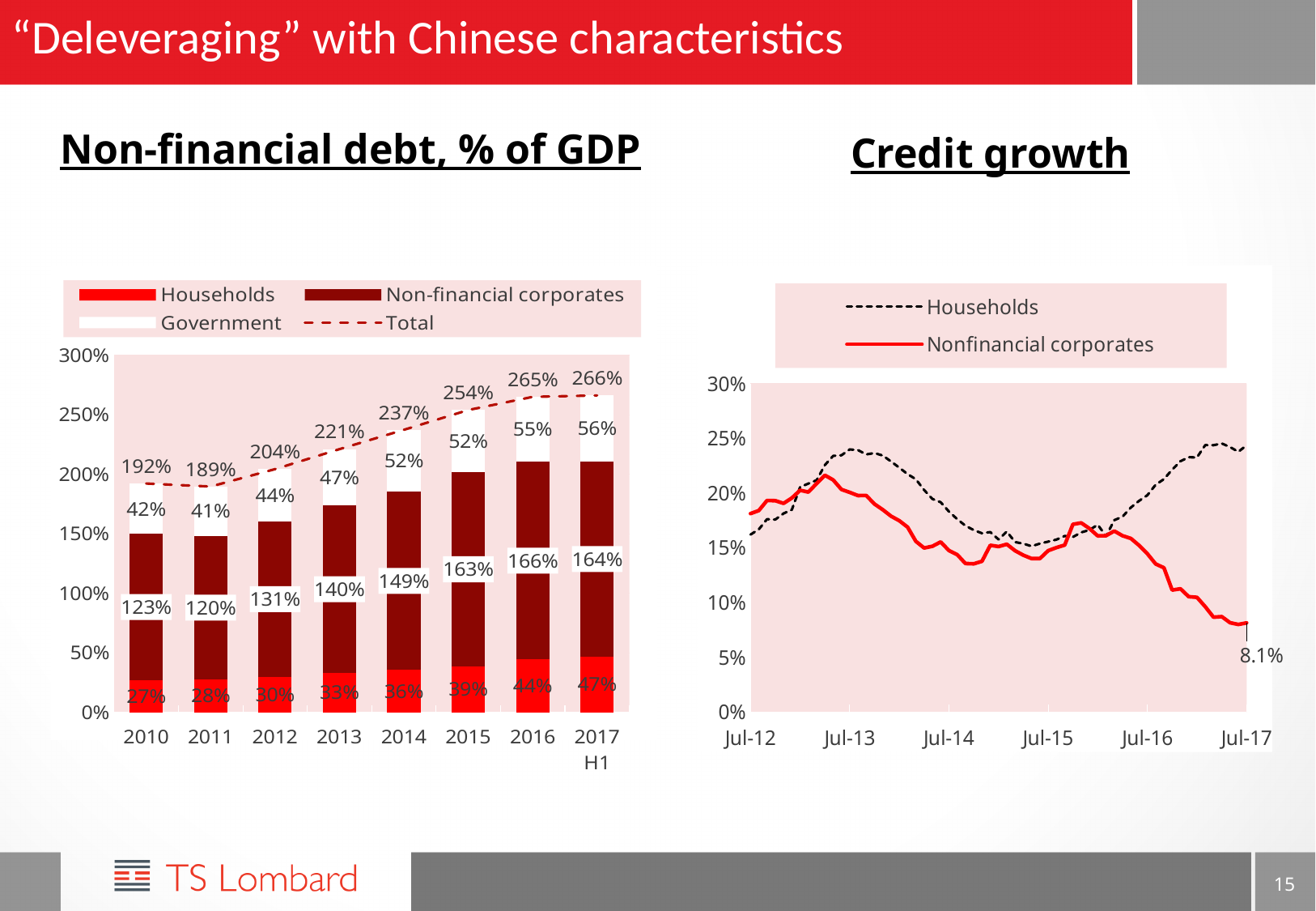
In the Non-financial debt, % of GDP chart, what is the Total value for 2013? 221% In the Non-financial debt, % of GDP chart, is the Non-financial corporates value larger in 2016 or in 2017 H1? 2016 In the Non-financial debt, % of GDP chart, by how many percentage points did the Non-financial corporates value rise from 2010 to 2016? 43 percentage points How many time periods are shown on the x axis of the Non-financial debt, % of GDP chart? 8 What kind of chart is the Credit growth chart? Line chart In the Non-financial debt, % of GDP chart, what is the value for Non-financial corporates in 2014? 149% In the Credit growth chart, is the Households value at Jul-17 greater or less than 20%? greater How many series does the legend of the Non-financial debt, % of GDP chart list? 4 In the Credit growth chart, what is the labelled value for Nonfinancial corporates at Jul-17? 8.1% In the Non-financial debt, % of GDP chart, which year has the highest Total? 2017 H1 In the Non-financial debt, % of GDP chart, what is the Households value for 2017 H1? 47% In the Non-financial debt, % of GDP chart, which year has the lowest Government value? 2011